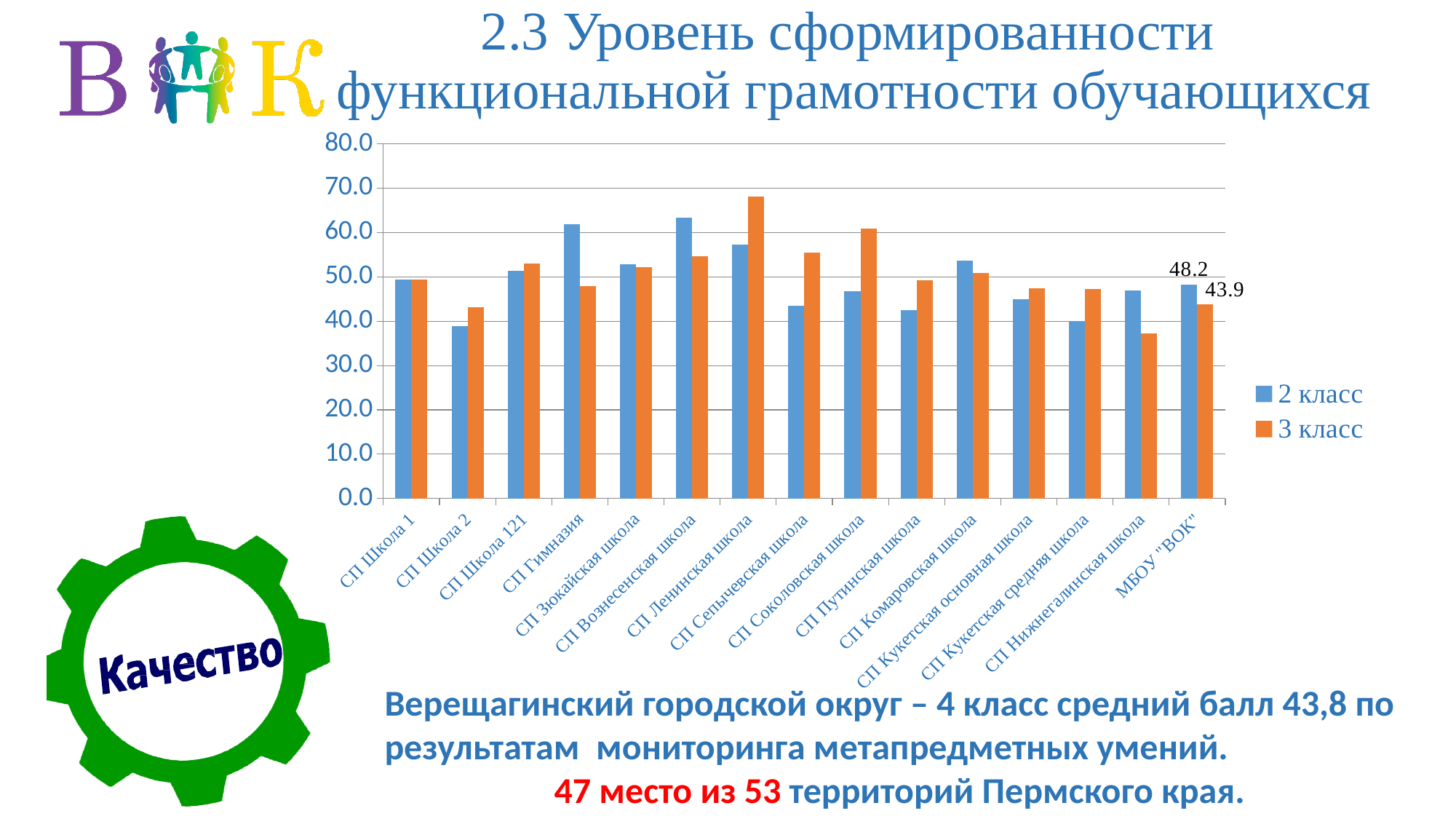
Which category has the highest value for 3 класс? СП Ленинская школа Which category has the lowest value for 3 класс? СП Нижнегалинская школа Is the 3 класс value for СП Ленинская школа greater or less than 60? greater For СП Соколовская школа, which series has the larger value, 2 класс or 3 класс? 3 класс How many categories are shown on the x axis of the chart? 15 What is the value for 3 класс at МБОУ "ВОК"? 43.9 What is the value for 2 класс at МБОУ "ВОК"? 48.2 Is the 3 класс value for СП Нижнегалинская школа greater or less than 40? less What is the difference between the 2 класс and 3 класс values for МБОУ "ВОК"? 4.3 For МБОУ "ВОК", which series has the larger value, 2 класс or 3 класс? 2 класс How many series does the legend list? 2 For СП Гимназия, which series has the larger value, 2 класс or 3 класс? 2 класс